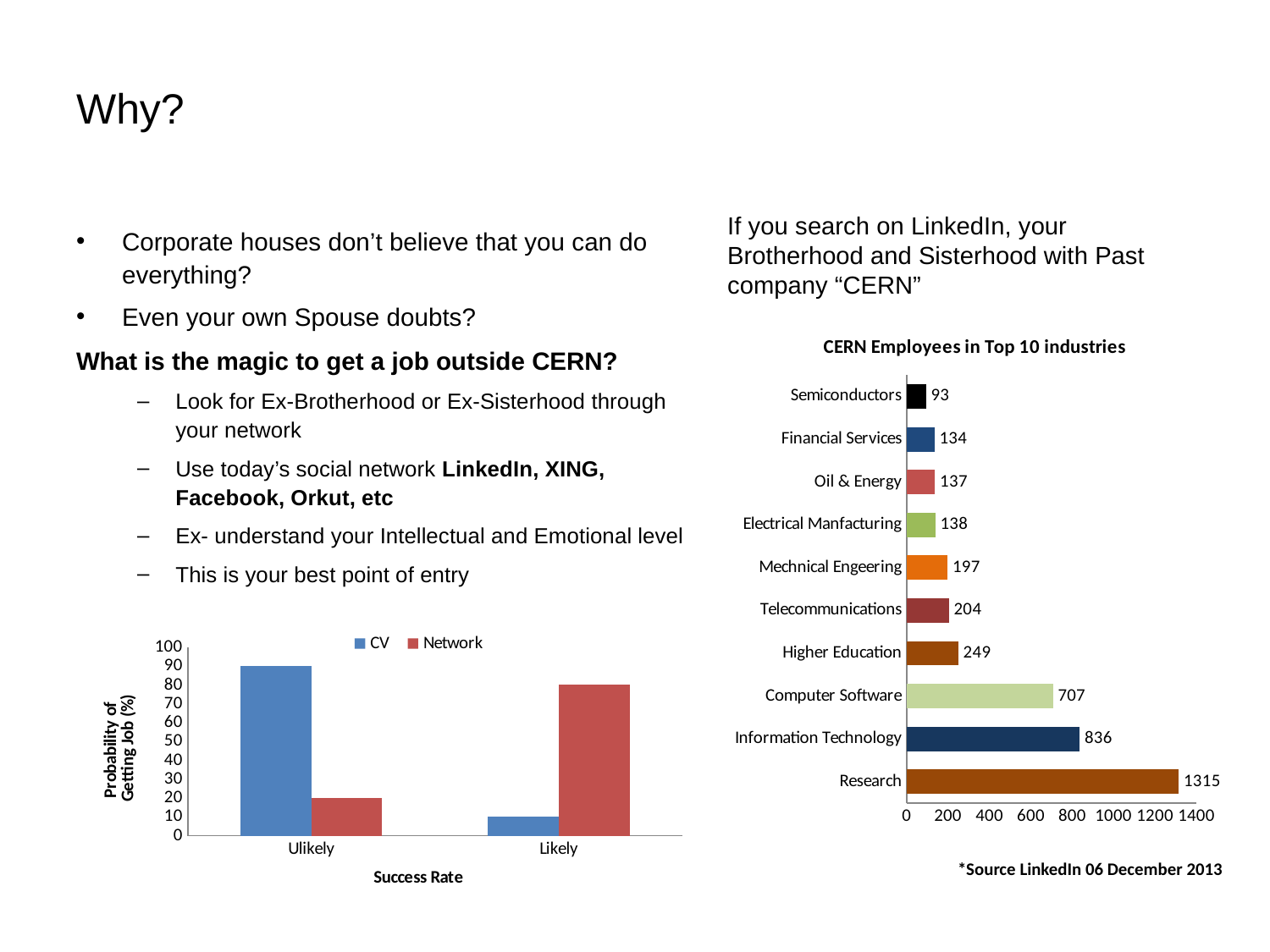
How many industries are shown in the 'CERN Employees in Top 10 industries' chart? 10 In the 'CERN Employees in Top 10 industries' chart, what is the value for Research? 1315 In the 'CERN Employees in Top 10 industries' chart, which industry has the lowest value? Semiconductors In the 'Success Rate' chart, which is larger for Likely, CV or Network? Network In the 'CERN Employees in Top 10 industries' chart, what is the value for Computer Software? 707 In the 'Success Rate' chart, is the CV value for Ulikely greater or less than 80? greater In the 'CERN Employees in Top 10 industries' chart, what is the value for Mechnical Engeering? 197 In the 'CERN Employees in Top 10 industries' chart, which industry has the highest value? Research How many series does the legend of the 'Success Rate' chart list? 2 In the 'CERN Employees in Top 10 industries' chart, what is the difference between Information Technology and Computer Software? 129 In the 'CERN Employees in Top 10 industries' chart, which is larger, Telecommunications or Higher Education? Higher Education What kind of chart is the 'Success Rate' chart on the left of the slide? Bar chart